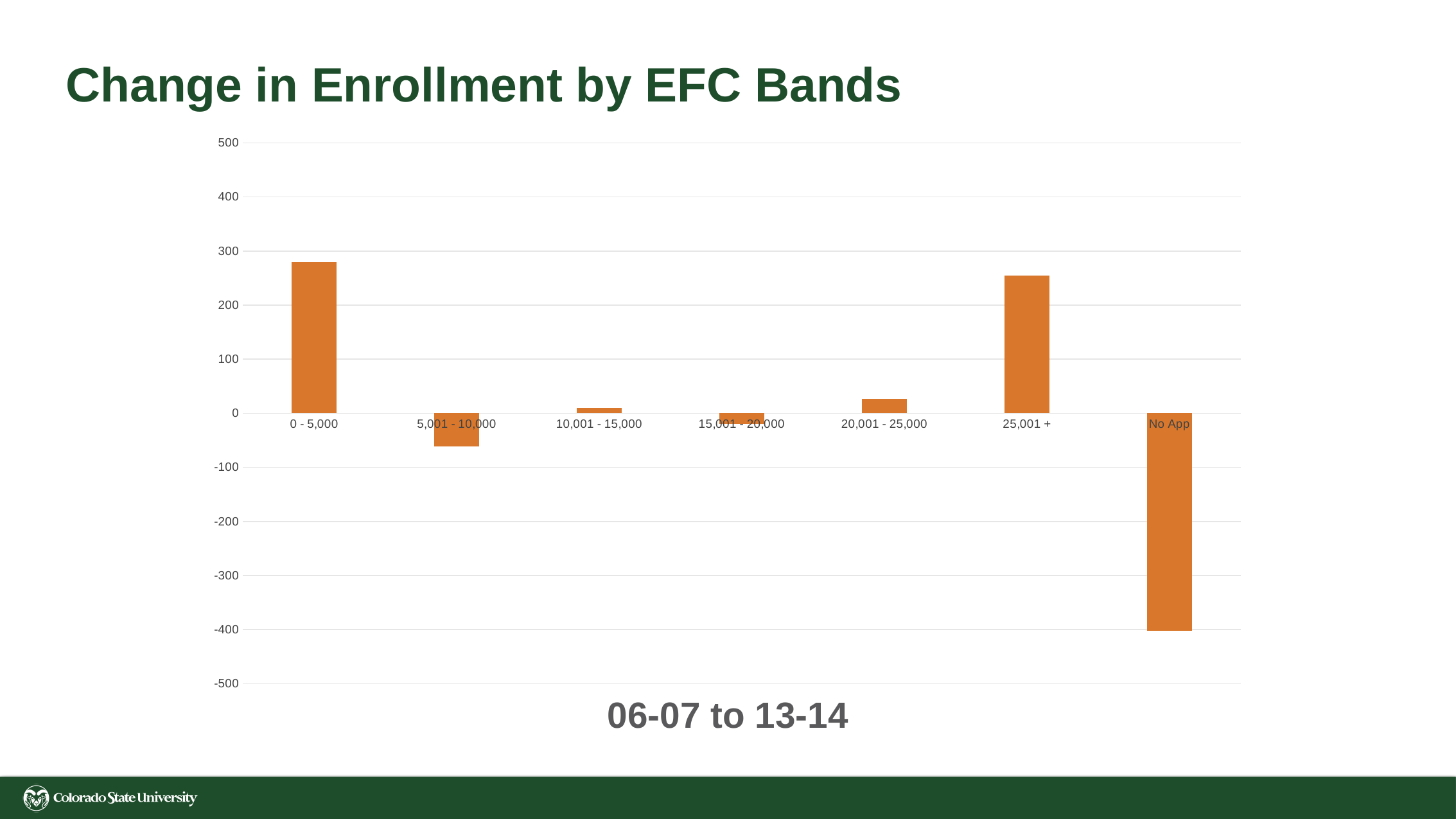
What kind of chart is shown on the slide? bar chart Is the value for 20,001 - 25,000 greater or less than 100? less Is the value for 5,001 - 10,000 greater or less than 0? less Which category has the lowest value on the chart? No App Is the value for 25,001 + greater or less than 300? less Which category has the highest value on the chart? 0 - 5,000 How many EFC band categories are plotted on the chart? 7 Which is larger, the value for 0 - 5,000 or the value for 20,001 - 25,000? 0 - 5,000 What is the title of the chart on the slide? Change in Enrollment by EFC Bands What time period is shown in the text below the chart? 06-07 to 13-14